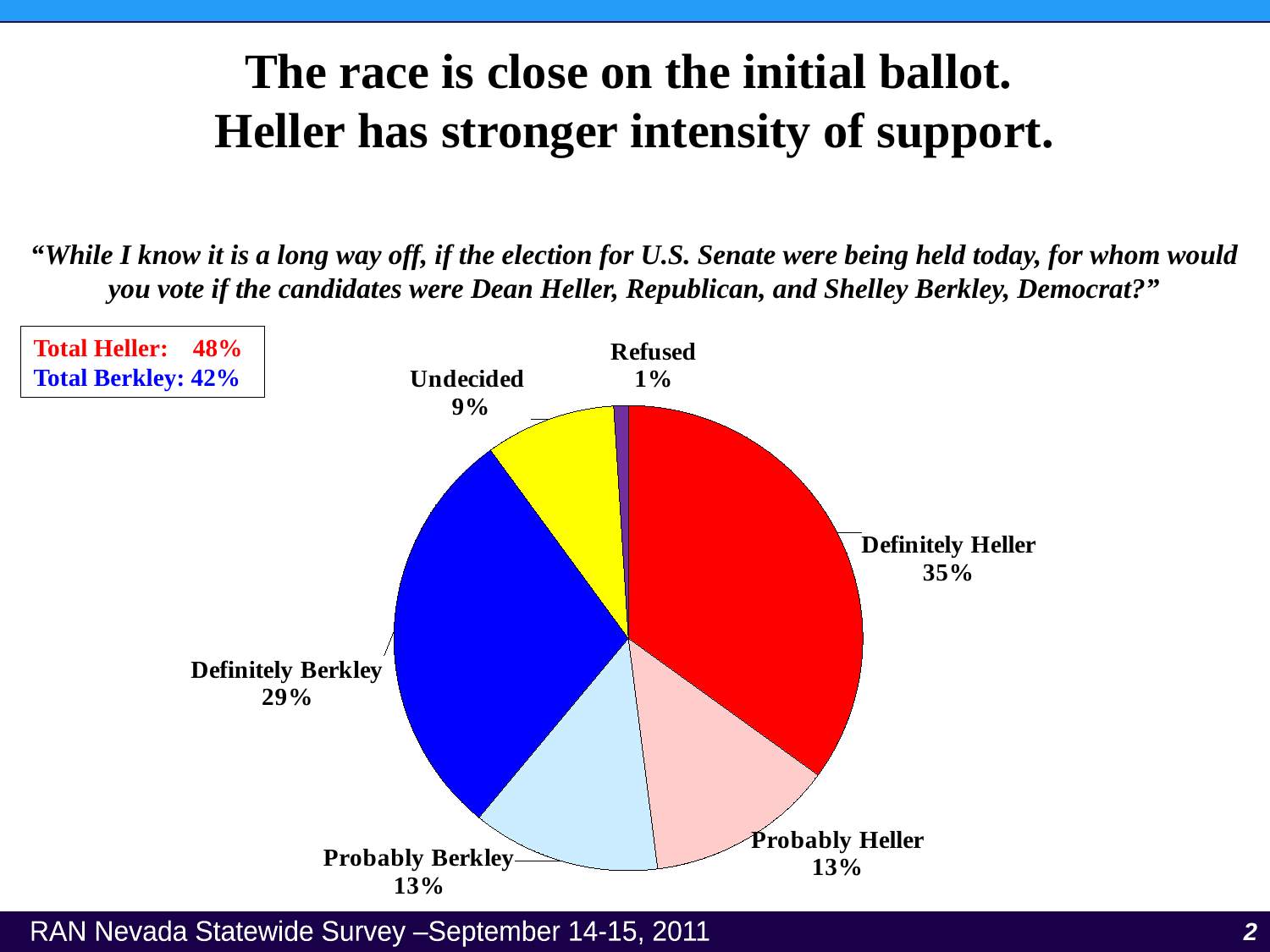
What is the combined share of Probably Heller and Probably Berkley? 26% What colour is the Undecided slice? yellow What percentage of respondents Refused? 1% Which slice of the pie is the largest? Definitely Heller What percentage of respondents were Undecided? 9% What is the difference between Definitely Heller and Definitely Berkley? 6% How many slices does the pie chart have? 6 What percentage of respondents said Definitely Berkley? 29% Which is larger, Undecided or Refused? Undecided What kind of chart is shown on the slide? pie chart Which slice of the pie is the smallest? Refused What percentage of respondents said Definitely Heller? 35%